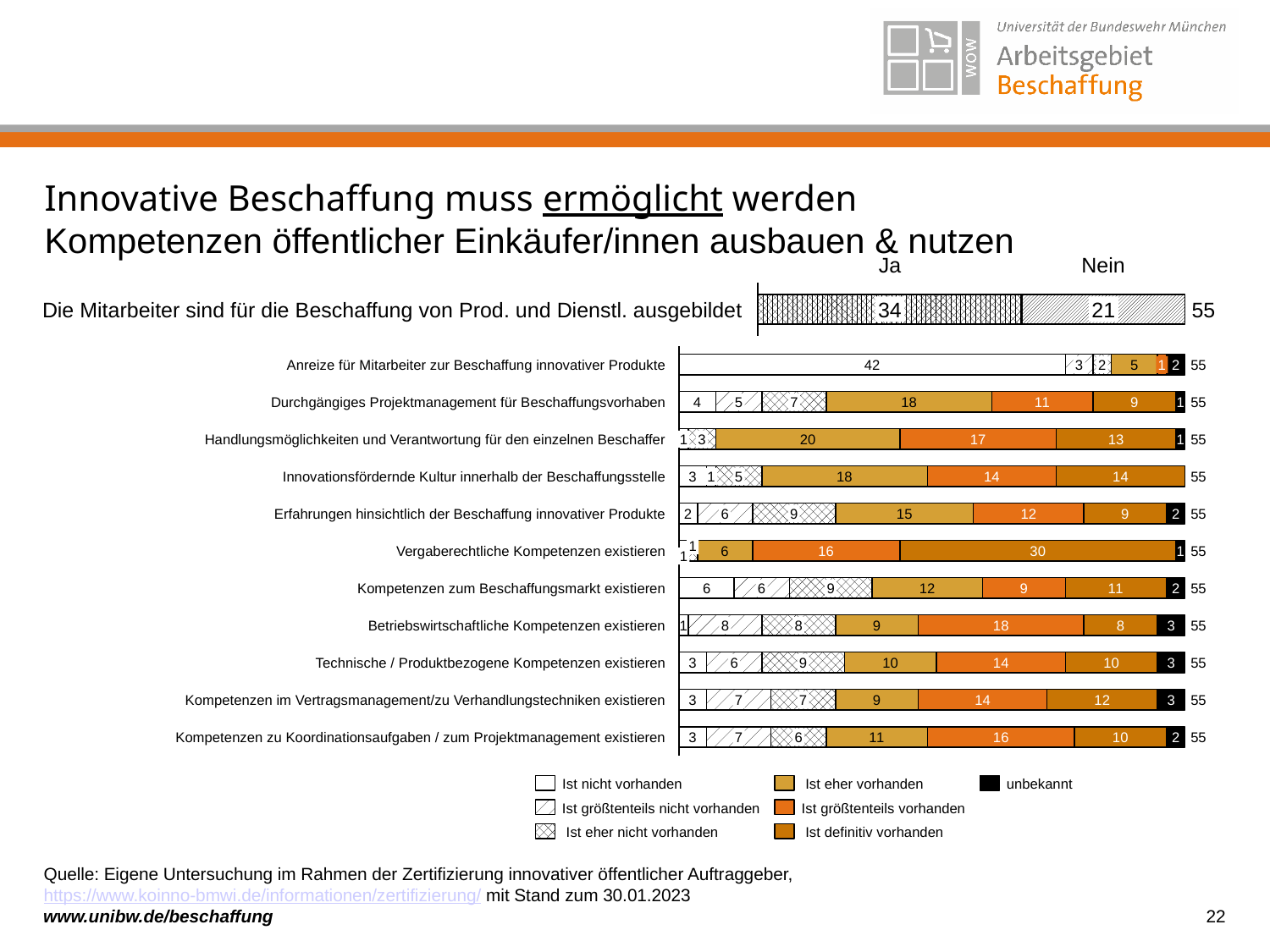
In the top chart, how much larger is the 'Ja' value than the 'Nein' value? 13 In the main chart below, how many series does the legend list? 7 In the main chart below, how many categories (rows) are plotted? 11 In the main chart below, what is the 'Ist definitiv vorhanden' value for 'Vergaberechtliche Kompetenzen existieren'? 30 In the main chart below, which category has the highest 'Ist nicht vorhanden' value? Anreize für Mitarbeiter zur Beschaffung innovativer Produkte In the main chart below, what kind of chart is it? Stacked bar chart In the top chart (Die Mitarbeiter sind für die Beschaffung von Prod. und Dienstl. ausgebildet), what is the value for 'Ja'? 34 In the top chart, what is the total shown at the end of the bar? 55 In the main chart below, what is the 'Ist eher vorhanden' value for 'Handlungsmöglichkeiten und Verantwortung für den einzelnen Beschaffer'? 20 In the main chart below, which has the larger 'Ist definitiv vorhanden' value: 'Innovationsfördernde Kultur innerhalb der Beschaffungsstelle' or 'Erfahrungen hinsichtlich der Beschaffung innovativer Produkte'? Innovationsfördernde Kultur innerhalb der Beschaffungsstelle In the main chart below, what colour represents 'unbekannt' in the legend? Black In the top chart (Die Mitarbeiter sind für die Beschaffung von Prod. und Dienstl. ausgebildet), what is the value for 'Nein'? 21